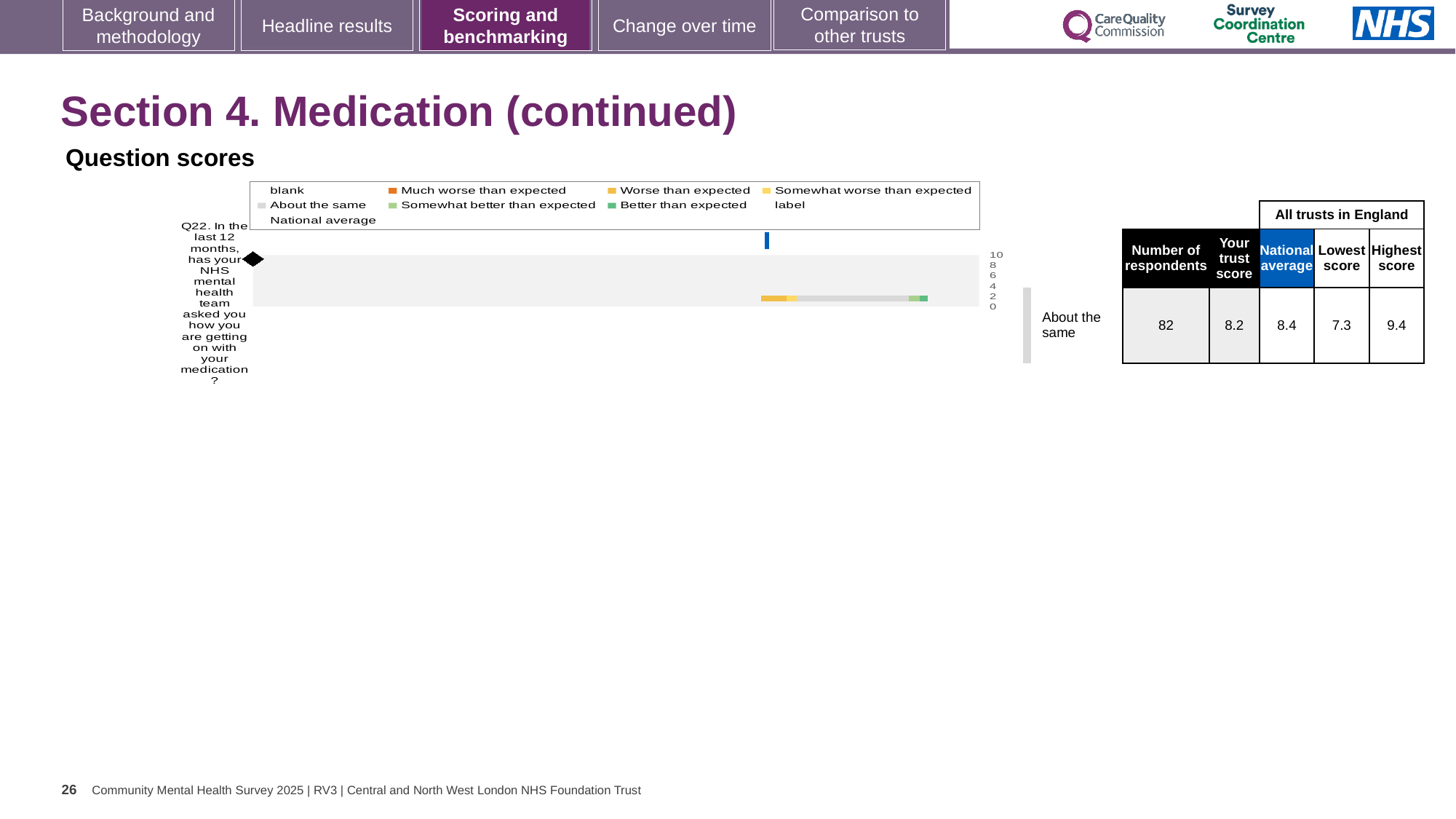
What is the highest score among all trusts in England for Q22? 9.4 What is the trust's score for Q22? 8.2 What is the lowest score among all trusts in England for Q22? 7.3 What kind of chart is used to show the question scores for Q22? bar chart What is the difference between the highest and lowest scores for Q22 across all trusts in England? 2.1 How many respondents answered Q22? 82 Which is larger for Q22, the trust's score or the national average? National average What benchmark category is the trust's Q22 score placed in? About the same What is the national average score for Q22? 8.4 What is the difference between the national average and the trust's score for Q22? 0.2 Which question is plotted in the question scores chart? Q22. In the last 12 months, has your NHS mental health team asked you how you are getting on with your medication? How many questions are plotted in the question scores chart? 1